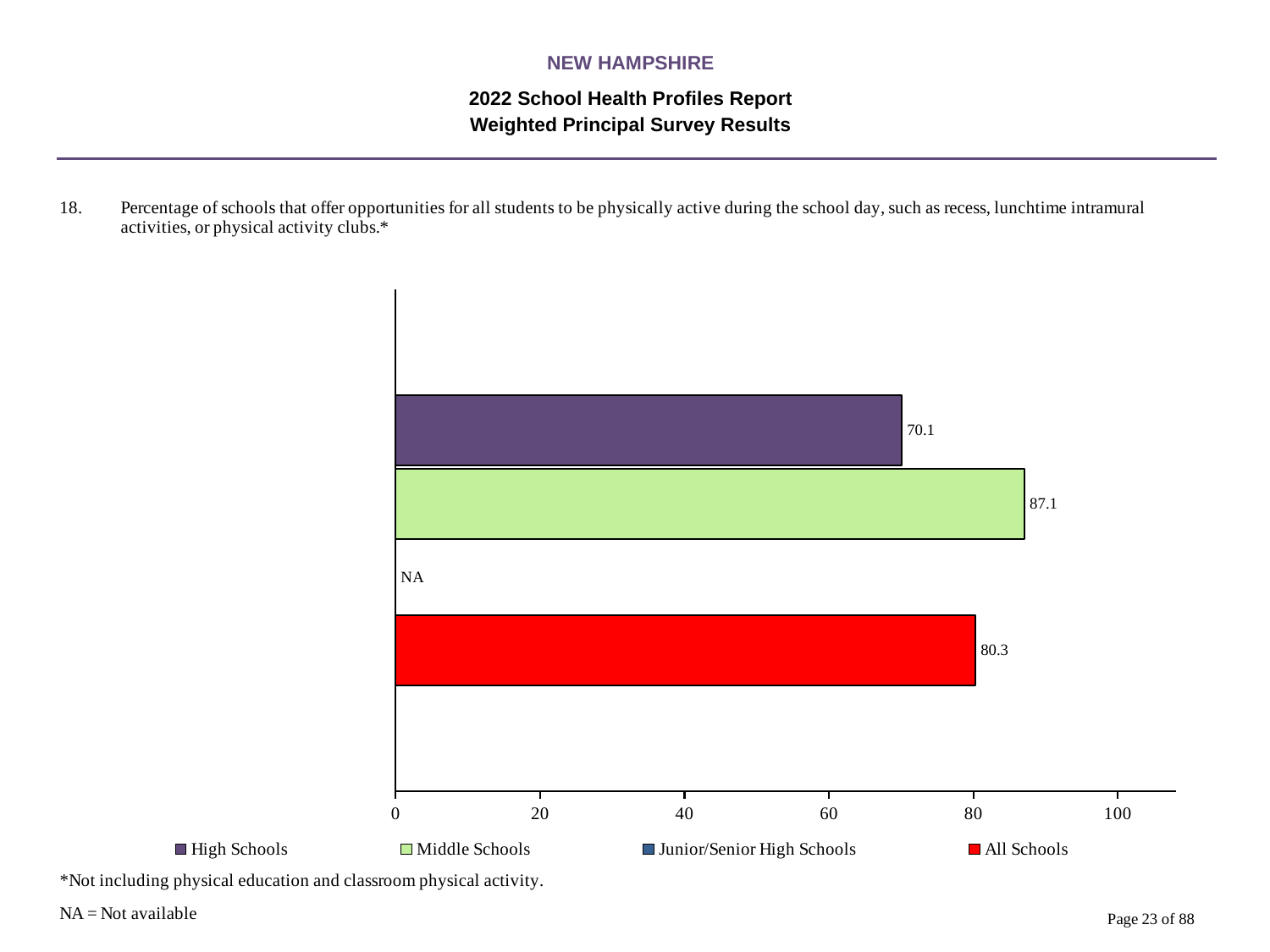
What is the value for High Schools? 70.1 What kind of chart is this? bar chart Which school type has the highest value? Middle Schools How many series does the legend list? 4 What is the difference between the Middle Schools value and the High Schools value? 17.0 What is the value for Middle Schools? 87.1 What is the value for All Schools? 80.3 Which school type with a plotted value has the lowest value? High Schools Which is larger, the value for All Schools or the value for High Schools? All Schools What colour is the bar for All Schools? red Is the value for Middle Schools greater or less than 80? greater What is shown for Junior/Senior High Schools? NA